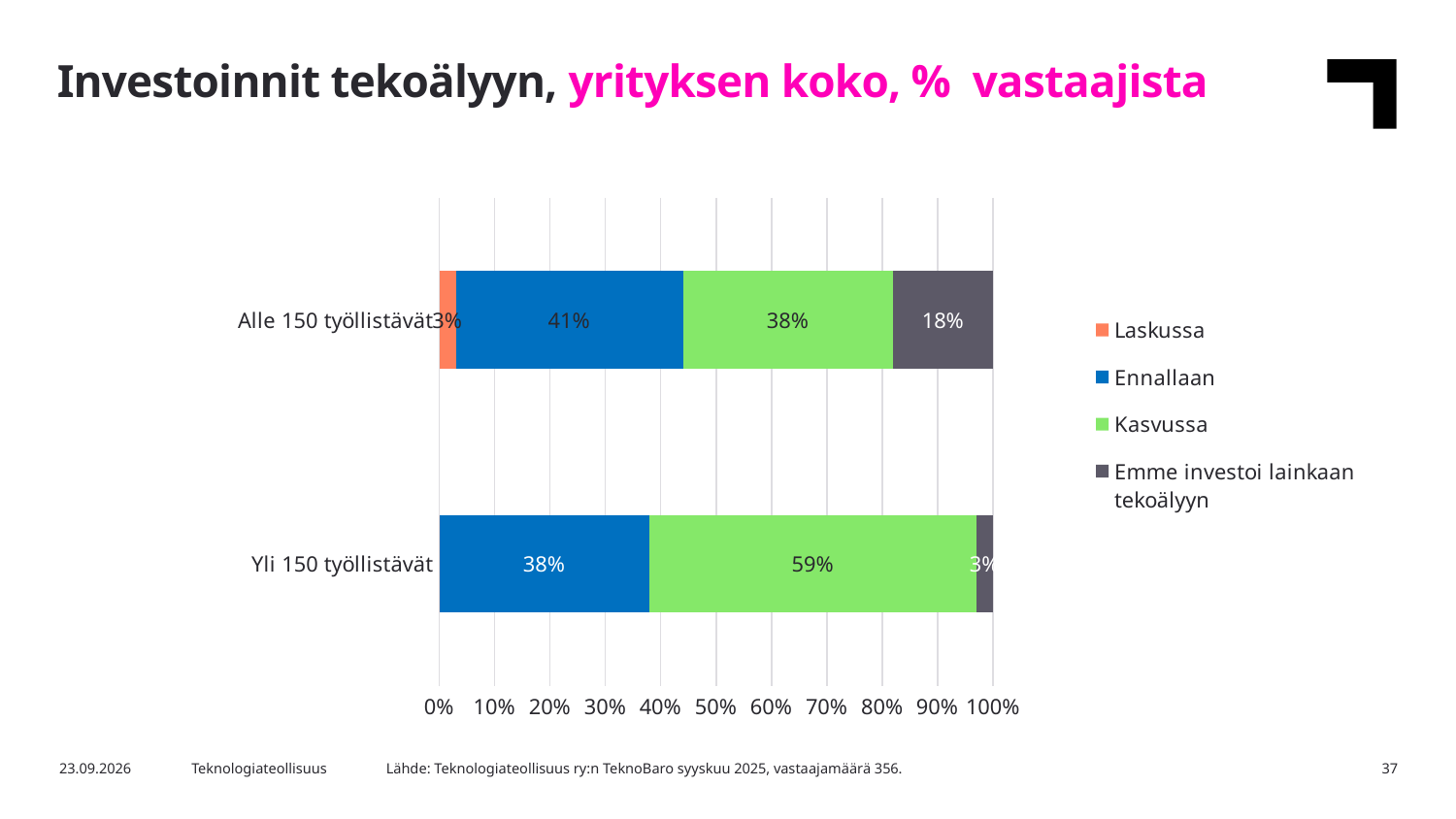
What is the Ennallaan value for Alle 150 työllistävät? 41% What is the Kasvussa value for Yli 150 työllistävät? 59% Which category has the higher Kasvussa value? Yli 150 työllistävät What is the Emme investoi lainkaan tekoälyyn value for Alle 150 työllistävät? 18% Which legend entry is shown in green? Kasvussa What kind of chart is shown on the slide? Stacked bar chart What is the difference between the Kasvussa values for Yli 150 työllistävät and Alle 150 työllistävät? 21 percentage points How many series does the legend list? 4 How many categories are shown on the vertical axis? 2 Which category has the larger Emme investoi lainkaan tekoälyyn share? Alle 150 työllistävät What is the Emme investoi lainkaan tekoälyyn value for Yli 150 työllistävät? 3% What is the Laskussa value for Alle 150 työllistävät? 3%